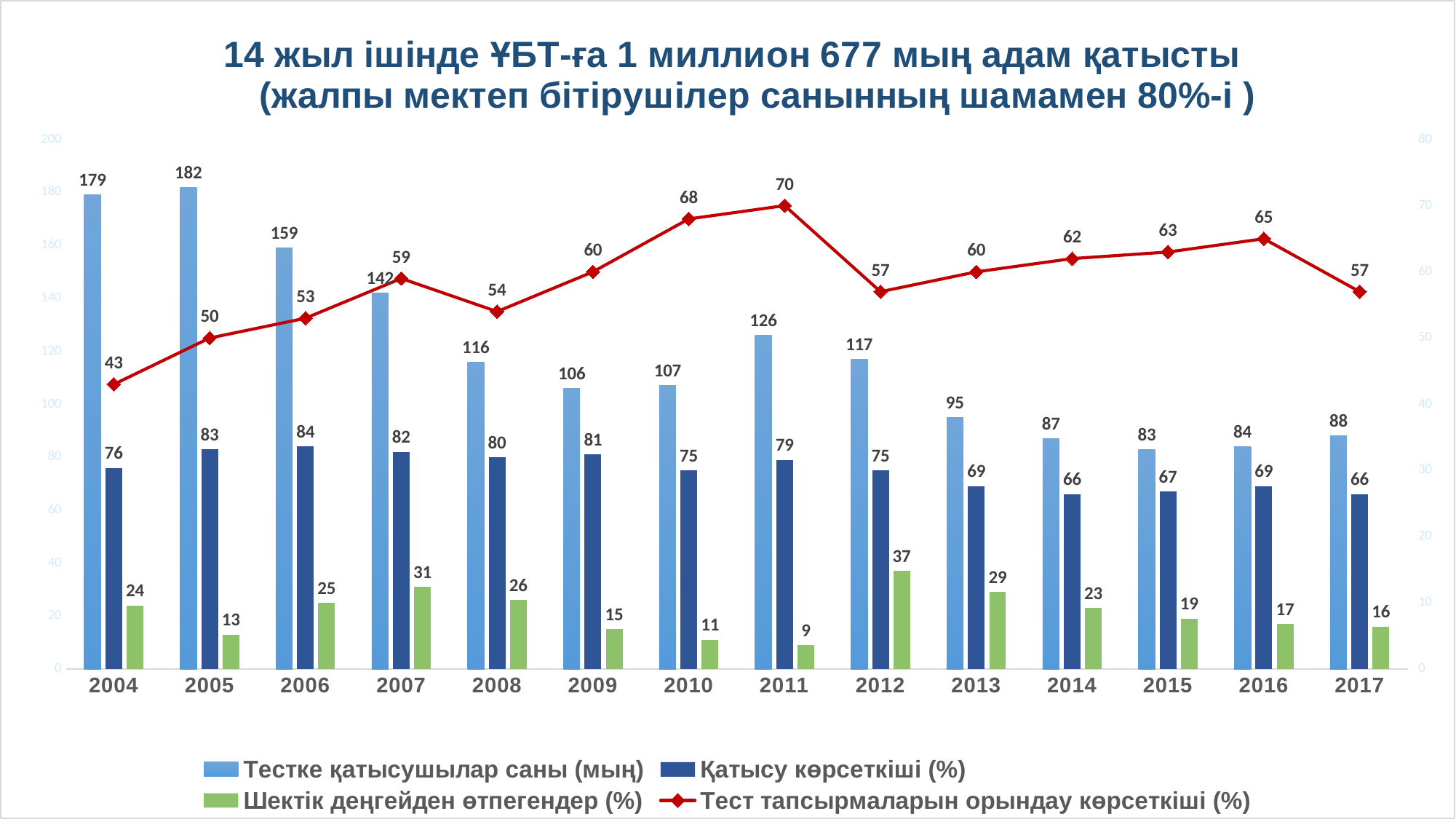
What is the value of Қатысу көрсеткіші (%) for 2017? 66 What is the value of Тест тапсырмаларын орындау көрсеткіші (%) for 2011? 70 What kind of chart is shown on the slide? Combined bar and line chart What is the value of Шектік деңгейден өтпегендер (%) for 2012? 37 In which year is Тестке қатысушылар саны (мың) the highest? 2005 How many years are shown on the x axis? 14 How many series does the legend list? 4 What is the value of Тестке қатысушылар саны (мың) for 2004? 179 What is the difference between Тестке қатысушылар саны (мың) in 2005 and in 2017? 94 In which year is Шектік деңгейден өтпегендер (%) the lowest? 2011 Does Тестке қатысушылар саны (мың) generally rise or fall from 2005 to 2015? Fall Which year has a higher Тест тапсырмаларын орындау көрсеткіші (%): 2010 or 2012? 2010